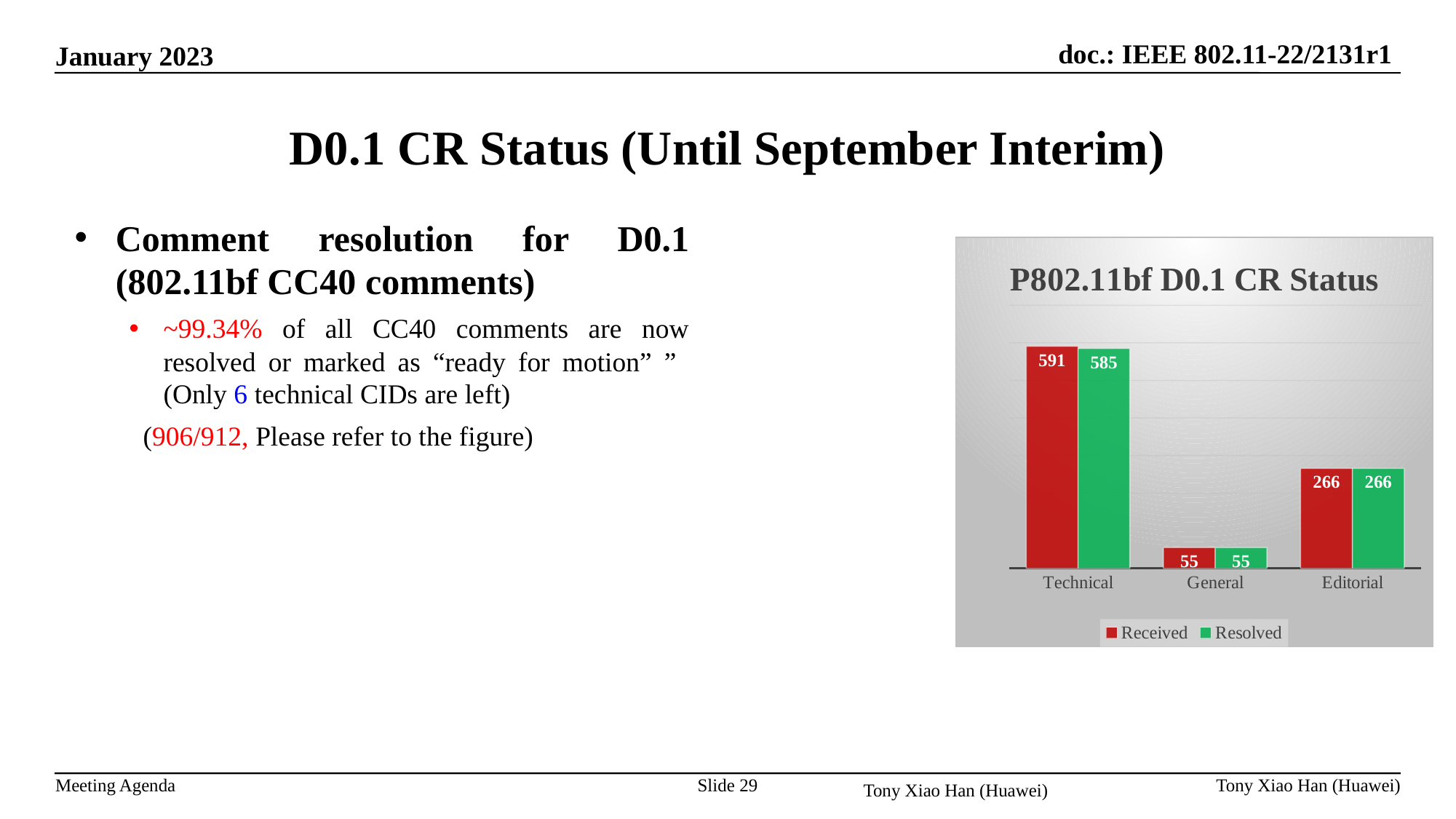
How many series does the legend list? 2 Which category has the highest Received value? Technical What is the difference between the Received values for Technical and Editorial? 325 What is the Received value for General? 55 What is the Resolved value for Editorial? 266 What is the Received value for Technical? 591 Which category has the lowest Resolved value? General How many categories are shown on the x axis? 3 What is the difference between Received and Resolved for Technical? 6 What is the Resolved value for Technical? 585 Which is larger, the Received value for Editorial or the Received value for General? Editorial What type of chart is shown? Bar chart